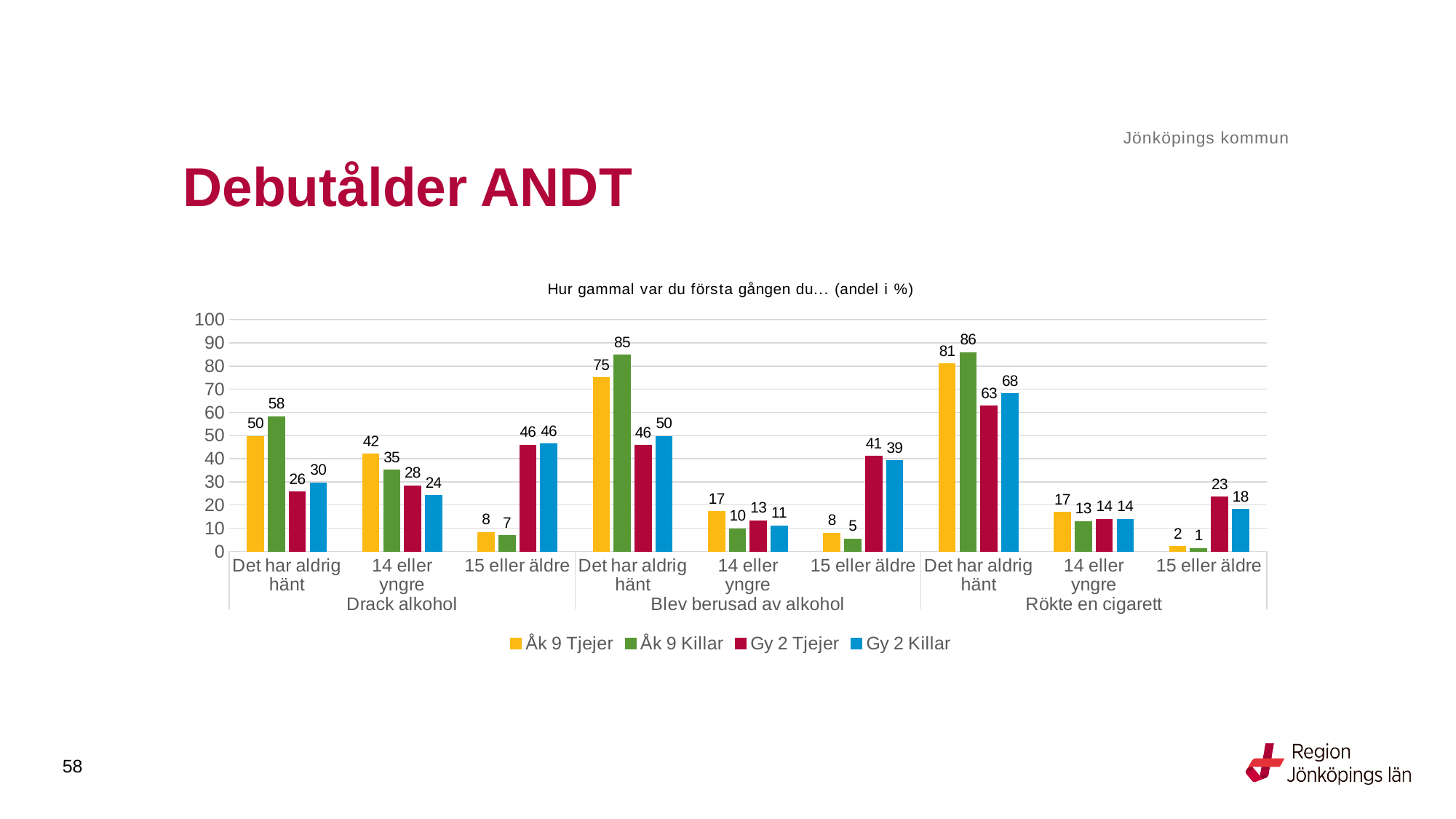
What is the value for Gy 2 Killar for 'Det har aldrig hänt' under 'Rökte en cigarett'? 68 How many series does the legend list? 4 Which series has the highest value for 'Det har aldrig hänt' under 'Blev berusad av alkohol'? Åk 9 Killar What is the title of the chart? Hur gammal var du första gången du… (andel i %) What is the value for Gy 2 Tjejer for '15 eller äldre' under 'Blev berusad av alkohol'? 41 What kind of chart is shown on the slide? bar chart What is the difference between Gy 2 Tjejer and Gy 2 Killar for '15 eller äldre' under 'Rökte en cigarett'? 5 How many categories are shown on the x axis in total? 9 What is the value for Åk 9 Killar for 'Det har aldrig hänt' under 'Drack alkohol'? 58 Which is larger for '14 eller yngre' under 'Blev berusad av alkohol': Åk 9 Tjejer or Gy 2 Killar? Åk 9 Tjejer What is the difference between Åk 9 Tjejer and Gy 2 Tjejer for '14 eller yngre' under 'Drack alkohol'? 14 Which series has the lowest value for '15 eller äldre' under 'Rökte en cigarett'? Åk 9 Killar